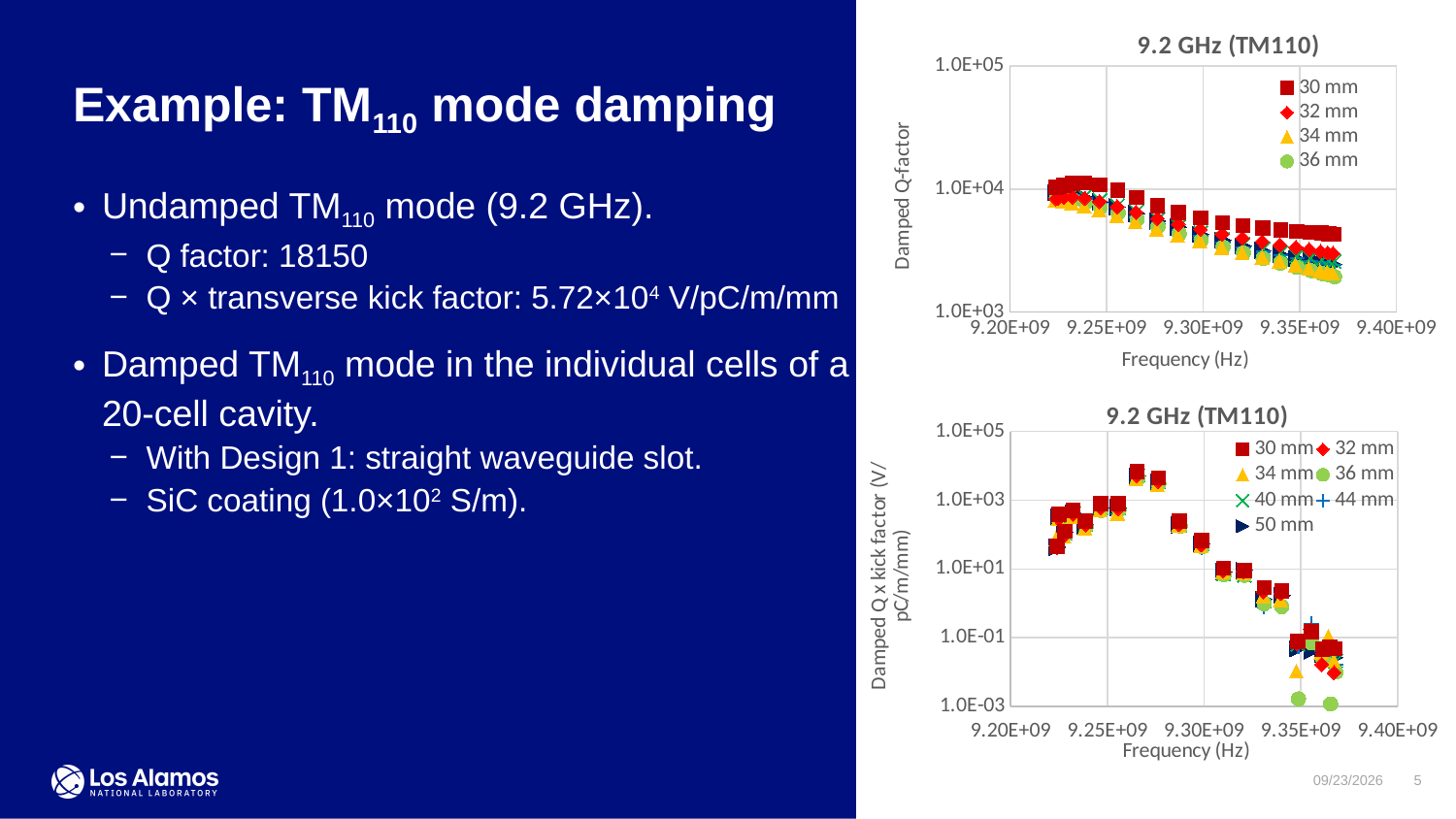
What kind of chart is the top chart (Damped Q-factor vs Frequency)? scatter chart In the bottom chart (Damped Q x kick factor), is the value for the 36 mm series near 9.35E+09 Hz greater or less than 1.0E-01? less What is the x-axis label of the bottom chart? Frequency (Hz) In the top chart (Damped Q-factor), do the values rise or fall as frequency increases? fall How many series does the legend of the bottom chart (Damped Q x kick factor) list? 7 How many series does the legend of the top chart (Damped Q-factor) list? 4 In the bottom chart (Damped Q x kick factor), is the highest value of the 30 mm series greater or less than 1.0E+03? greater What is the y-axis label of the top chart? Damped Q-factor In the top chart (Damped Q-factor), is the value for the 36 mm series near 9.36E+09 Hz greater or less than 1.0E+03? greater What is the title of the top chart on the slide? 9.2 GHz (TM110)